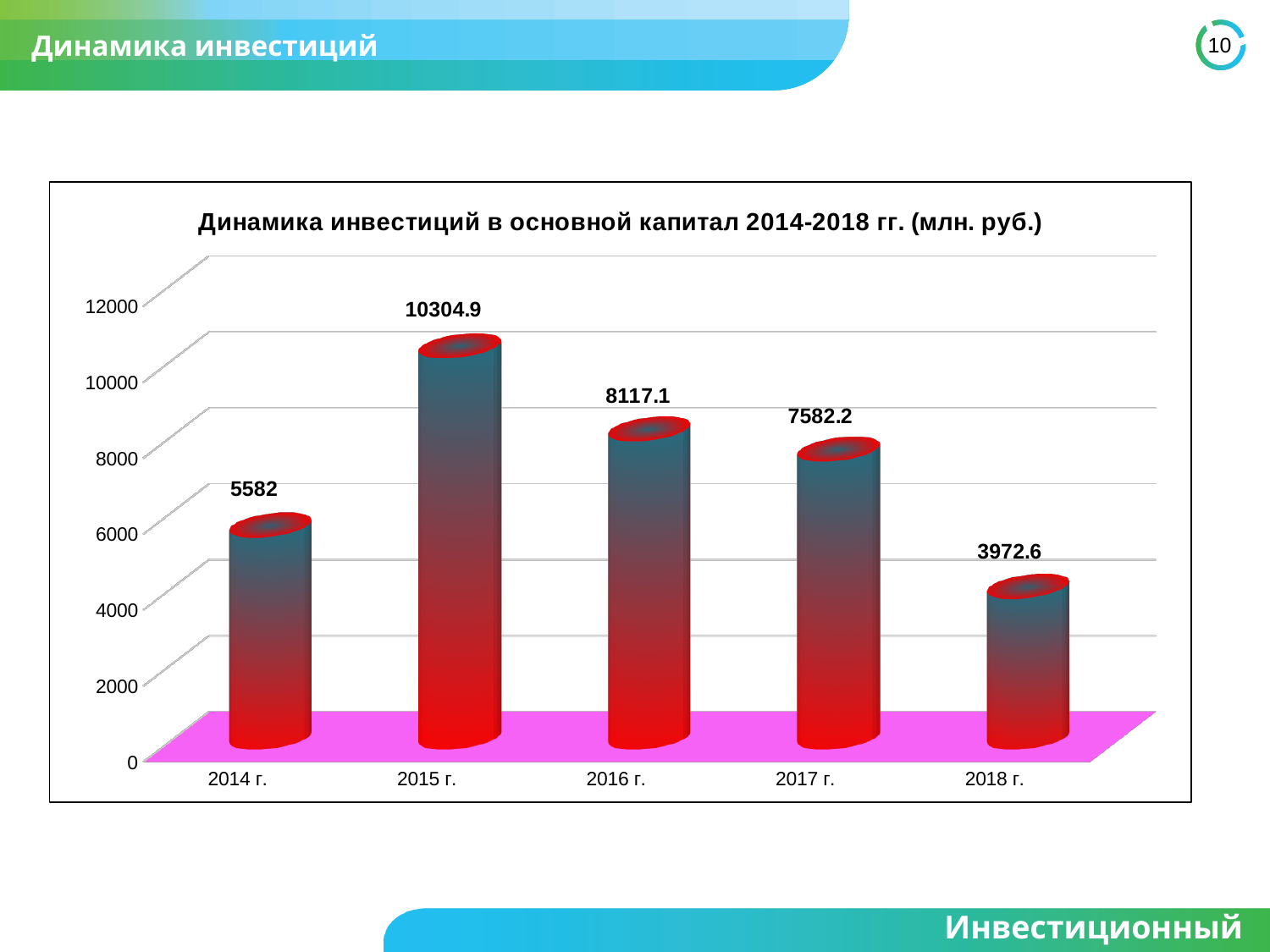
What is the value for 2015 г.? 10304.9 What is the difference between the values for 2016 г. and 2017 г.? 534.9 Which year has the highest value? 2015 г. Which is larger, the value for 2014 г. or the value for 2018 г.? 2014 г. What is the value for 2014 г.? 5582 What is the difference between the values for 2015 г. and 2014 г.? 4722.9 What kind of chart is this? bar chart How many years are shown on the x axis? 5 What is the value for 2018 г.? 3972.6 Which year has the lowest value? 2018 г. Do the values rise or fall from 2015 г. to 2018 г.? fall What is the title of the chart? Динамика инвестиций в основной капитал 2014-2018 гг. (млн. руб.)